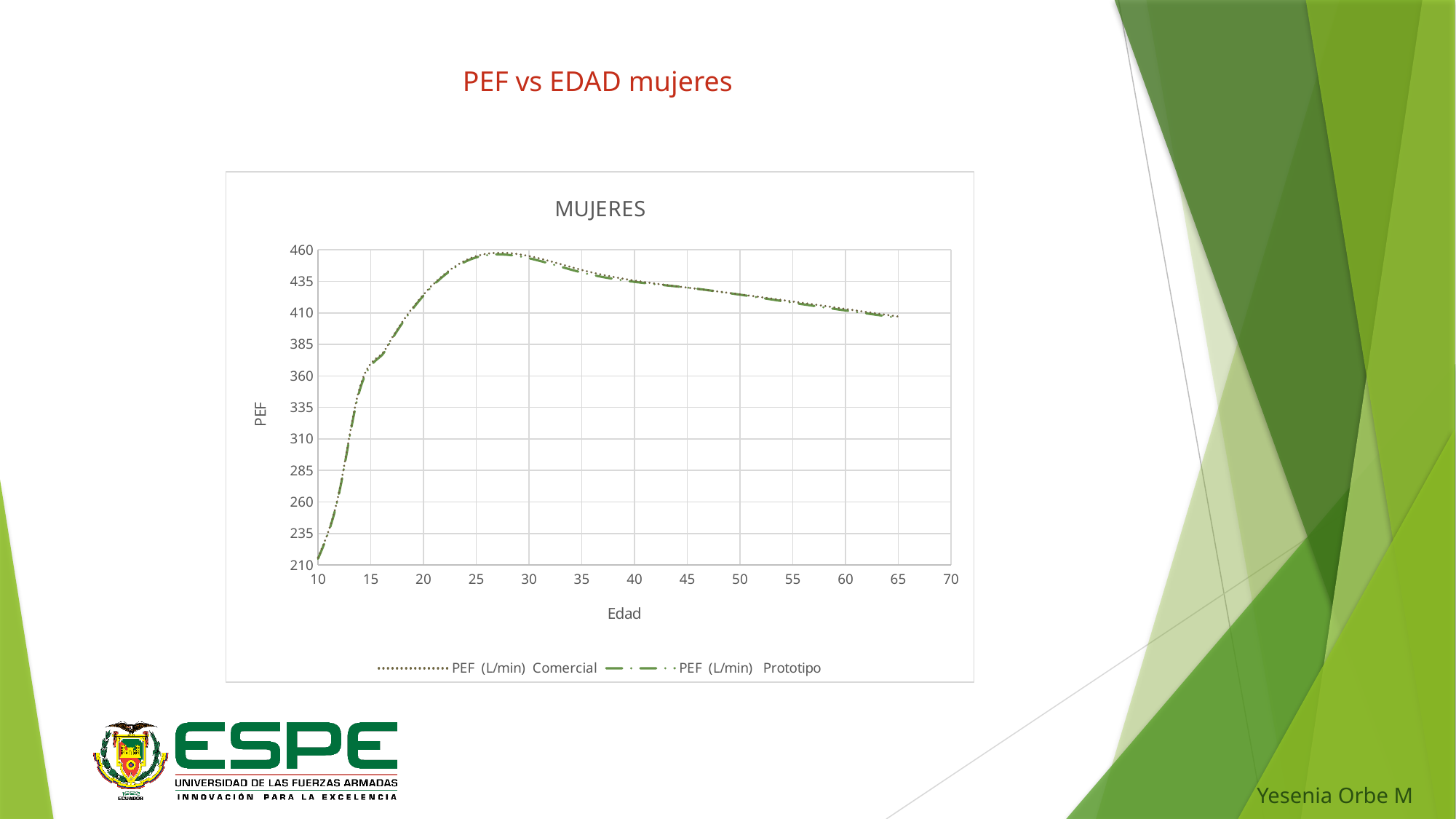
Do the PEF values rise or fall along the x axis between ages 30 and 65? fall Is the PEF value at age 15 greater or less than 335? greater What kind of chart is shown on the slide? line chart Is the PEF value at age 10 greater or less than 235? less Which is larger, the PEF value at age 20 or the PEF value at age 60? age 20 Is the PEF value at age 25 greater or less than 435? greater Do the PEF values rise or fall along the x axis between ages 10 and 25? rise What is the title of the chart? MUJERES How many series does the chart legend list? 2 What is the label of the x axis? Edad